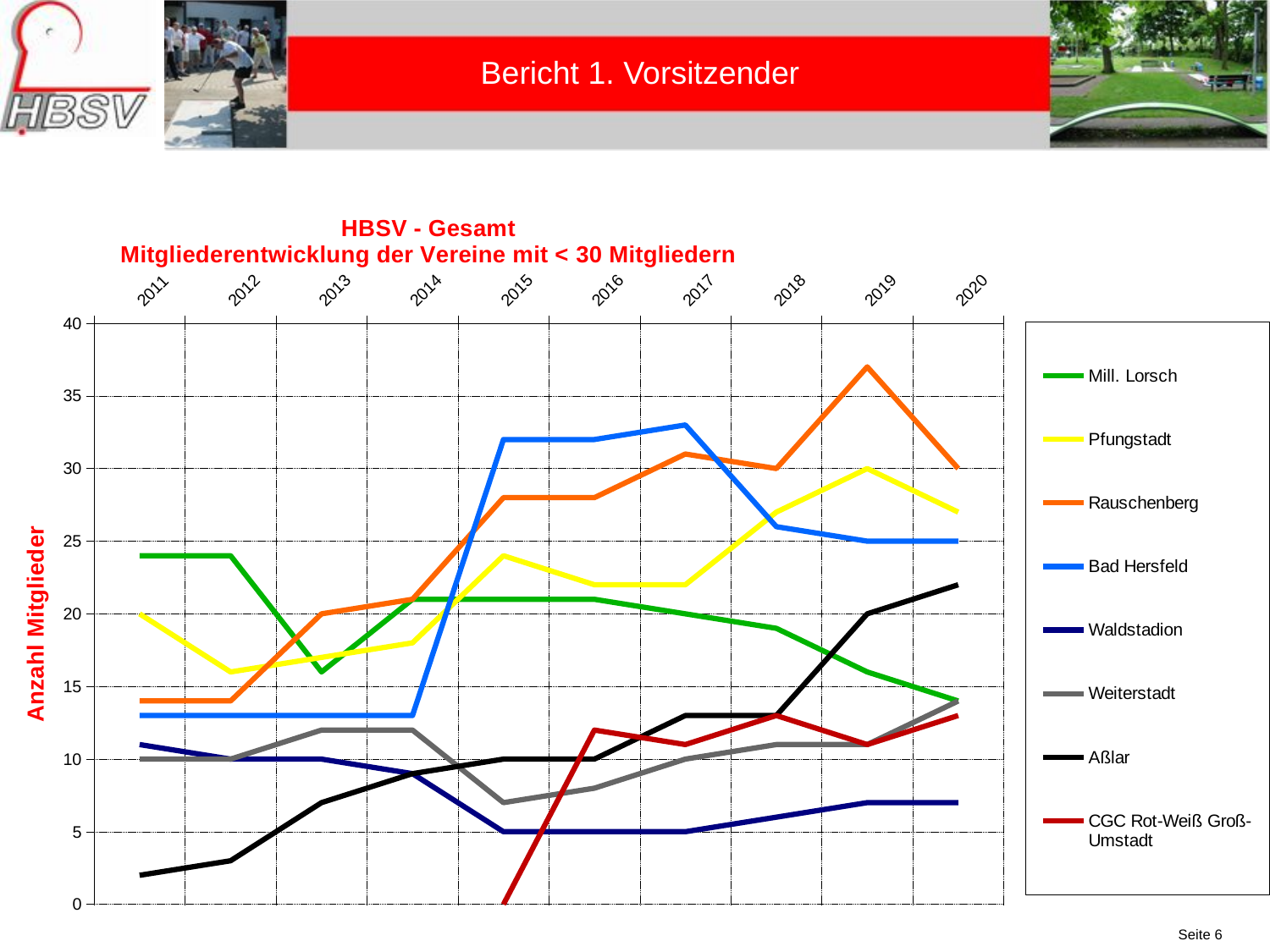
Is the value for Bad Hersfeld in 2015 greater or less than 30? greater How many series does the legend list? 8 In 2011, which club has more members, Mill. Lorsch or Pfungstadt? Mill. Lorsch What type of chart is shown on the slide? line chart What is the label of the y axis? Anzahl Mitglieder Is the value for Rauschenberg in 2019 greater or less than 35? greater Is the value for Waldstadion in 2016 greater or less than 10? less Which club has the lowest number of members in 2011? Aßlar In 2020, which club has more members, Rauschenberg or Pfungstadt? Rauschenberg How many years are plotted along the x axis? 10 Does the Aßlar line generally rise or fall from 2011 to 2020? rise Which club has the highest number of members in 2019? Rauschenberg